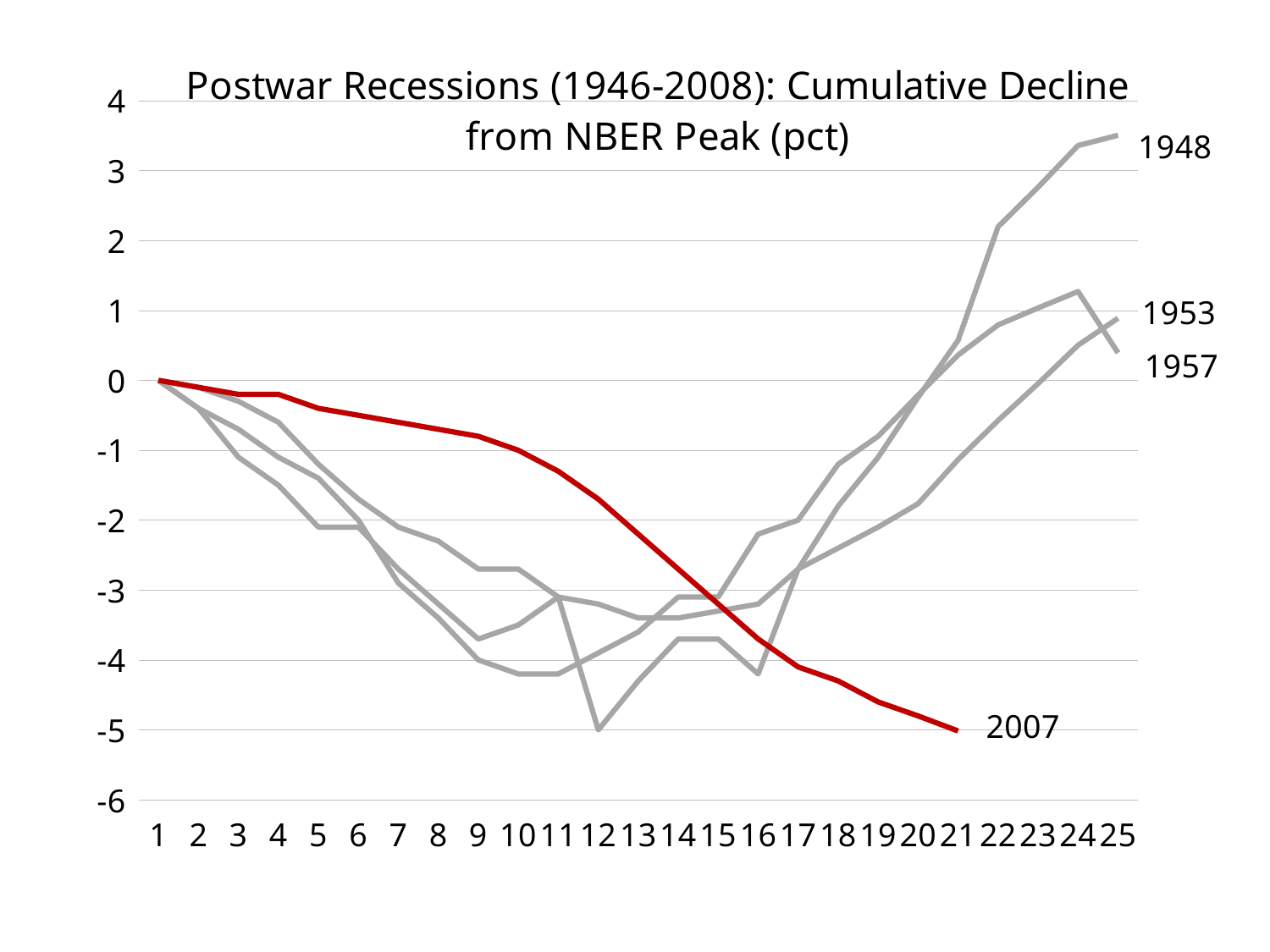
Which series has the highest value at point 25? 1948 Is the value for the 2007 series at point 21 greater or less than -4? less What kind of chart is shown on the slide? line chart What colour is the 2007 line? red Which series has the lowest value at point 21? 2007 What is the value of the 2007 series at point 1? 0 What is the title of the chart? Postwar Recessions (1946-2008): Cumulative Decline from NBER Peak (pct) How many points are shown along the x axis? 25 Is the value for the 2007 series at point 13 greater or less than -2? less Is the value for the 1948 series at point 25 greater or less than 3? greater Does the 2007 series rise or fall from point 1 to point 21? fall How many recession series are plotted on the chart? 4